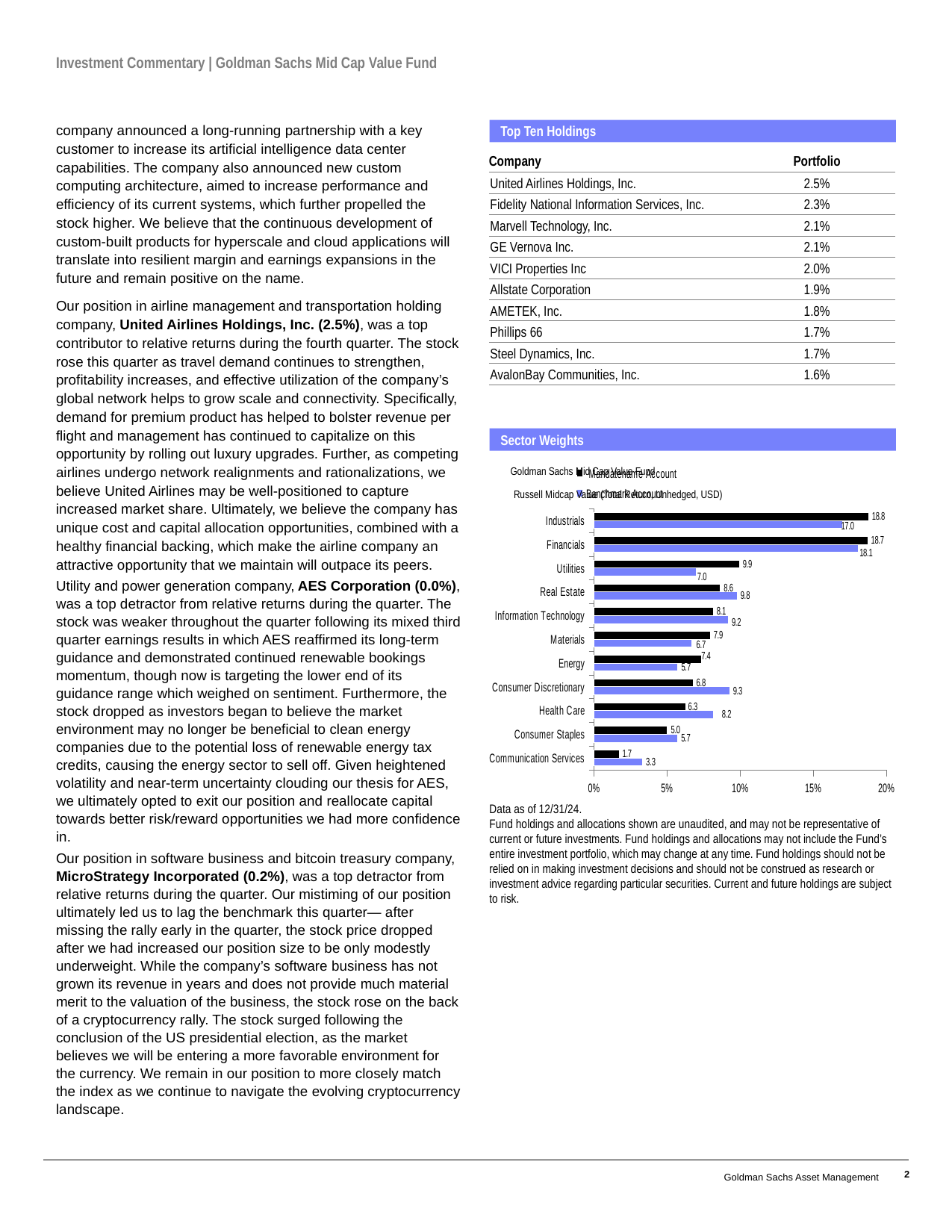
What type of chart is the Sector Weights chart? bar chart In the Sector Weights chart, which sector has the highest value for the blue bars? Financials How many sectors are shown in the Sector Weights chart? 11 In the Sector Weights chart, what is the value of the black bar for Utilities? 9.9 In the Sector Weights chart, is the black bar for Energy greater or less than 5%? greater In the Sector Weights chart, what is the value of the blue bar for Consumer Discretionary? 9.3 In the Sector Weights chart, what is the value of the black bar for Industrials? 18.8 In the Sector Weights chart, for Health Care, which is larger: the black bar or the blue bar? the blue bar In the Sector Weights chart, which sector has the lowest value for the black bars? Communication Services In the Sector Weights chart, what is the difference between the black bar and the blue bar for Utilities? 2.9 In the Sector Weights chart, what is the value of the blue bar for Financials? 18.1 How many series does the legend of the Sector Weights chart list? 2